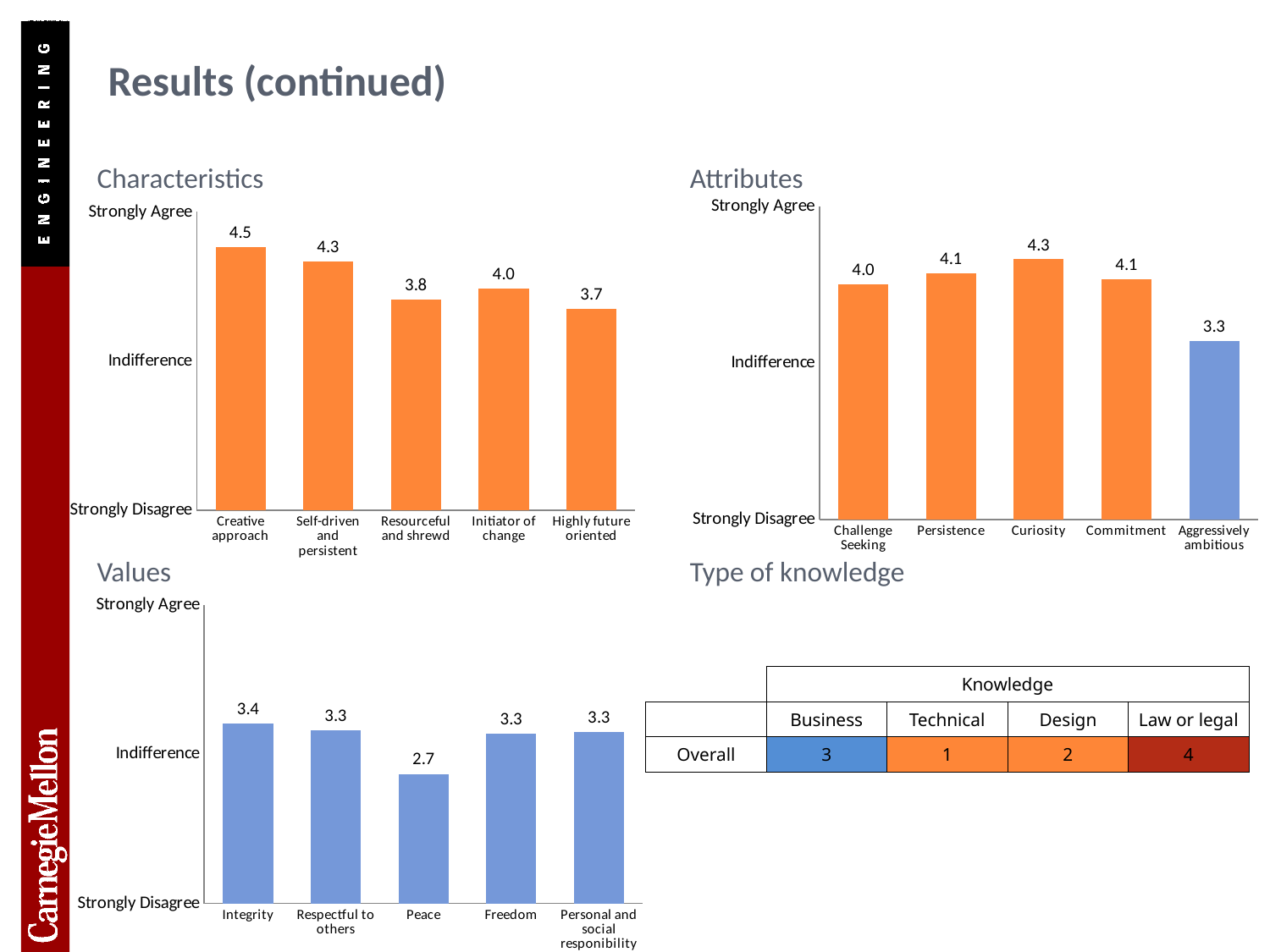
In the Characteristics chart, what is the value for Creative approach? 4.5 In the Characteristics chart, which category has the lowest value? Highly future oriented In the Values chart, what is the value for Peace? 2.7 In the Attributes chart, what is the difference between Curiosity and Aggressively ambitious? 1.0 In the Characteristics chart, what is the difference between Creative approach and Resourceful and shrewd? 0.7 What kind of chart is the Values chart? Bar chart In the Attributes chart, what is the value for Curiosity? 4.3 In the Characteristics chart, how many categories are shown? 5 In the Values chart, which category has the highest value? Integrity In the Attributes chart, which is larger, Challenge Seeking or Persistence? Persistence In the Attributes chart, which bar is coloured differently from the others? Aggressively ambitious In the Attributes chart, which category has the lowest value? Aggressively ambitious